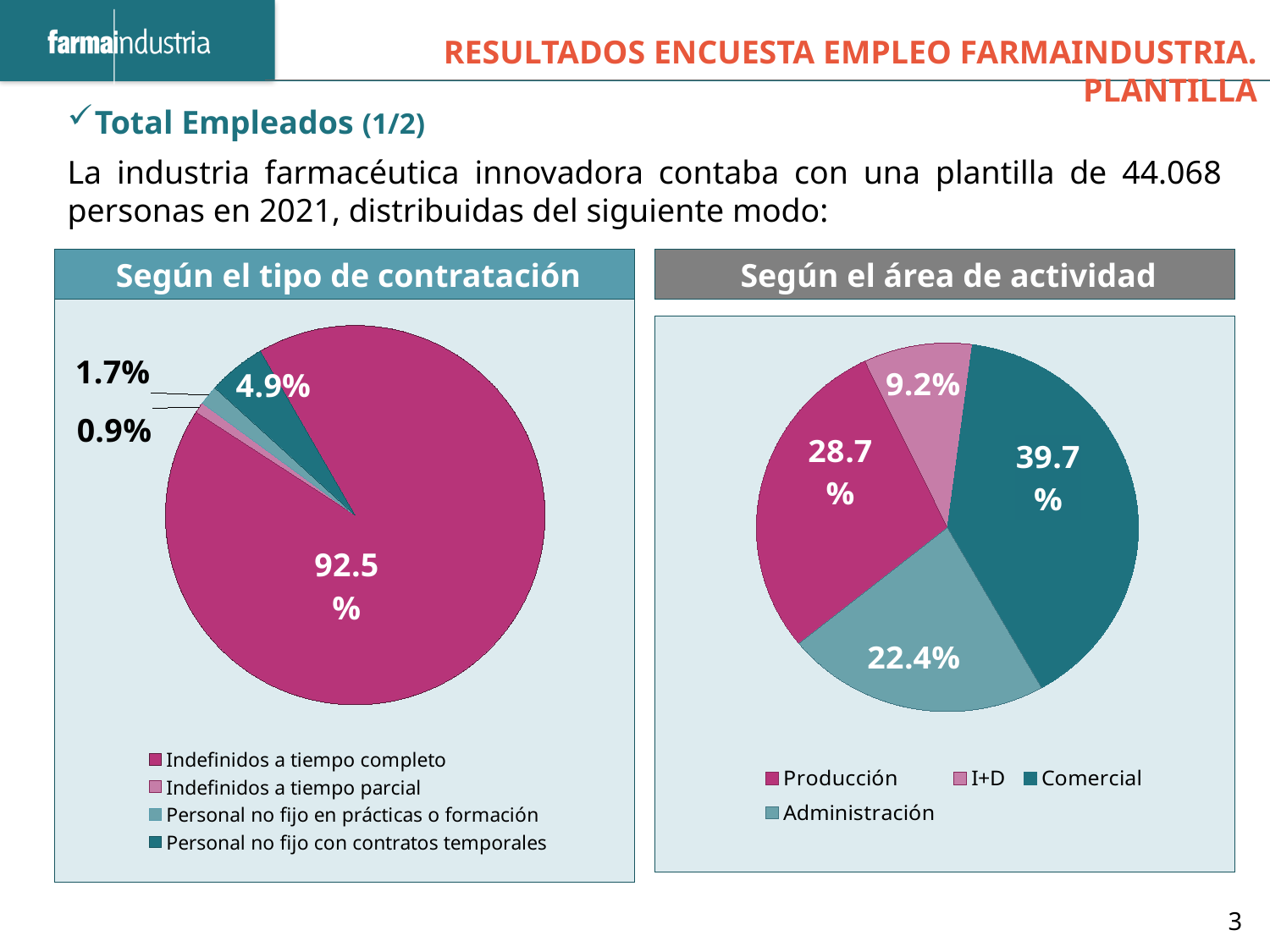
In the 'Según el área de actividad' pie chart, which is larger: Administración or Producción? Producción In the 'Según el tipo de contratación' pie chart, how many categories does the legend list? 4 In the 'Según el área de actividad' pie chart, what share is I+D? 9.2% In the 'Según el área de actividad' pie chart, what share is Producción? 28.7% In the 'Según el área de actividad' pie chart, what is the difference between the Comercial and Producción shares? 11 percentage points In the 'Según el área de actividad' pie chart, which area has the smallest share? I+D In the 'Según el área de actividad' pie chart, what share is Administración? 22.4% In the 'Según el área de actividad' pie chart, what share is Comercial? 39.7% In the 'Según el área de actividad' pie chart, which area has the largest share? Comercial In the 'Según el tipo de contratación' pie chart, what share is 'Personal no fijo con contratos temporales'? 4.9% What type of chart is used in the 'Según el área de actividad' panel? Pie chart In the 'Según el tipo de contratación' pie chart, what share is 'Indefinidos a tiempo completo'? 92.5%